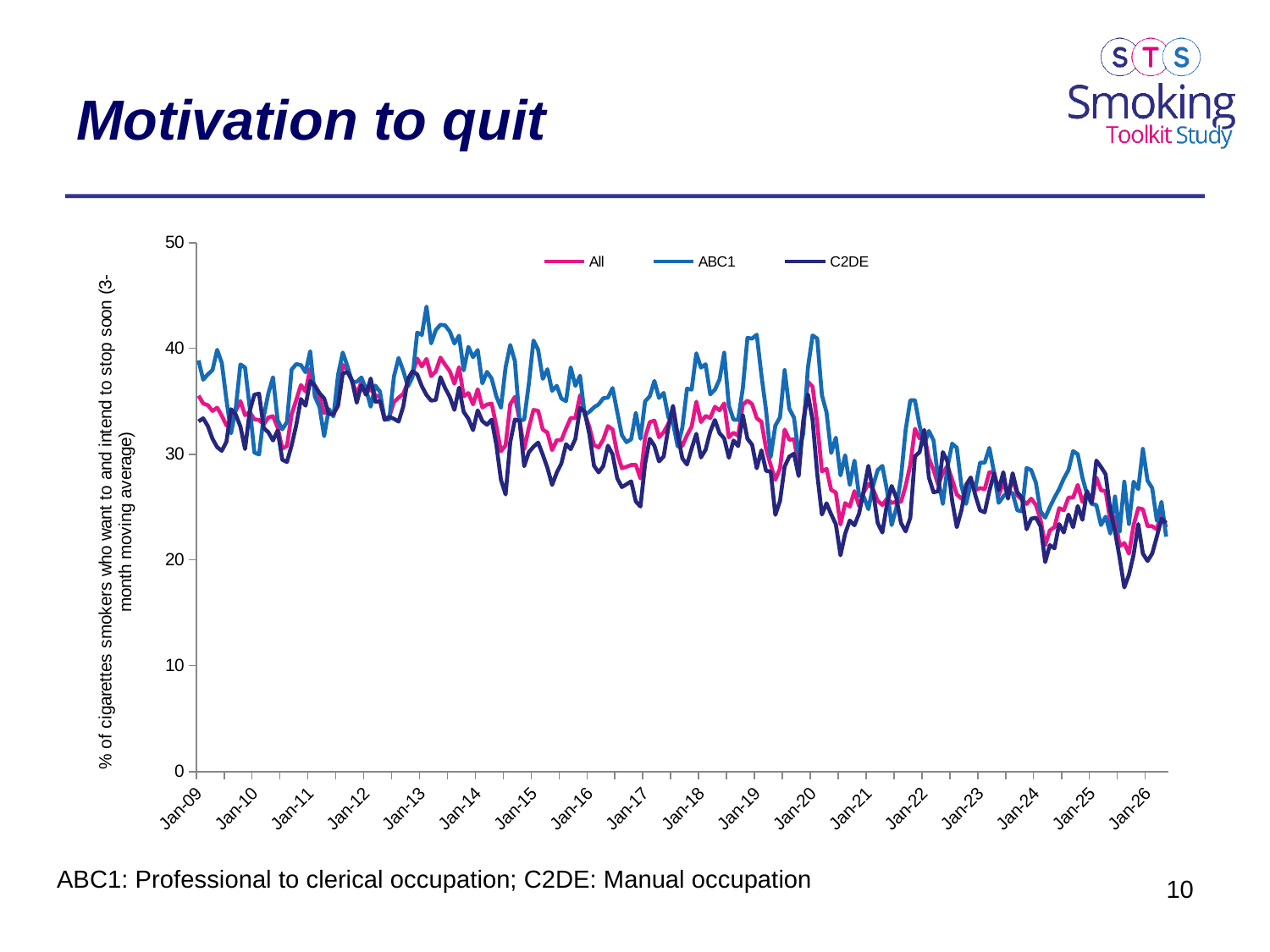
What are the three series named in the legend? All, ABC1, C2DE Overall, do the values rise or fall from Jan-09 to Jan-26? Fall Is the lowest value of the C2DE series, reached between Jan-25 and Jan-26, greater or less than 20? less How many series does the legend list? 3 What is the title of the slide containing the chart? Motivation to quit Is the value of the All series at Jan-26 greater or less than 30? less Is the peak value of the ABC1 series around Jan-13 greater or less than 40? greater What kind of chart is shown on the slide? Line chart How many year labels (Jan-09 through Jan-26) are shown on the x axis? 18 Which series reaches the lowest point on the chart? C2DE Around Jan-13, which series has the larger value, ABC1 or C2DE? ABC1